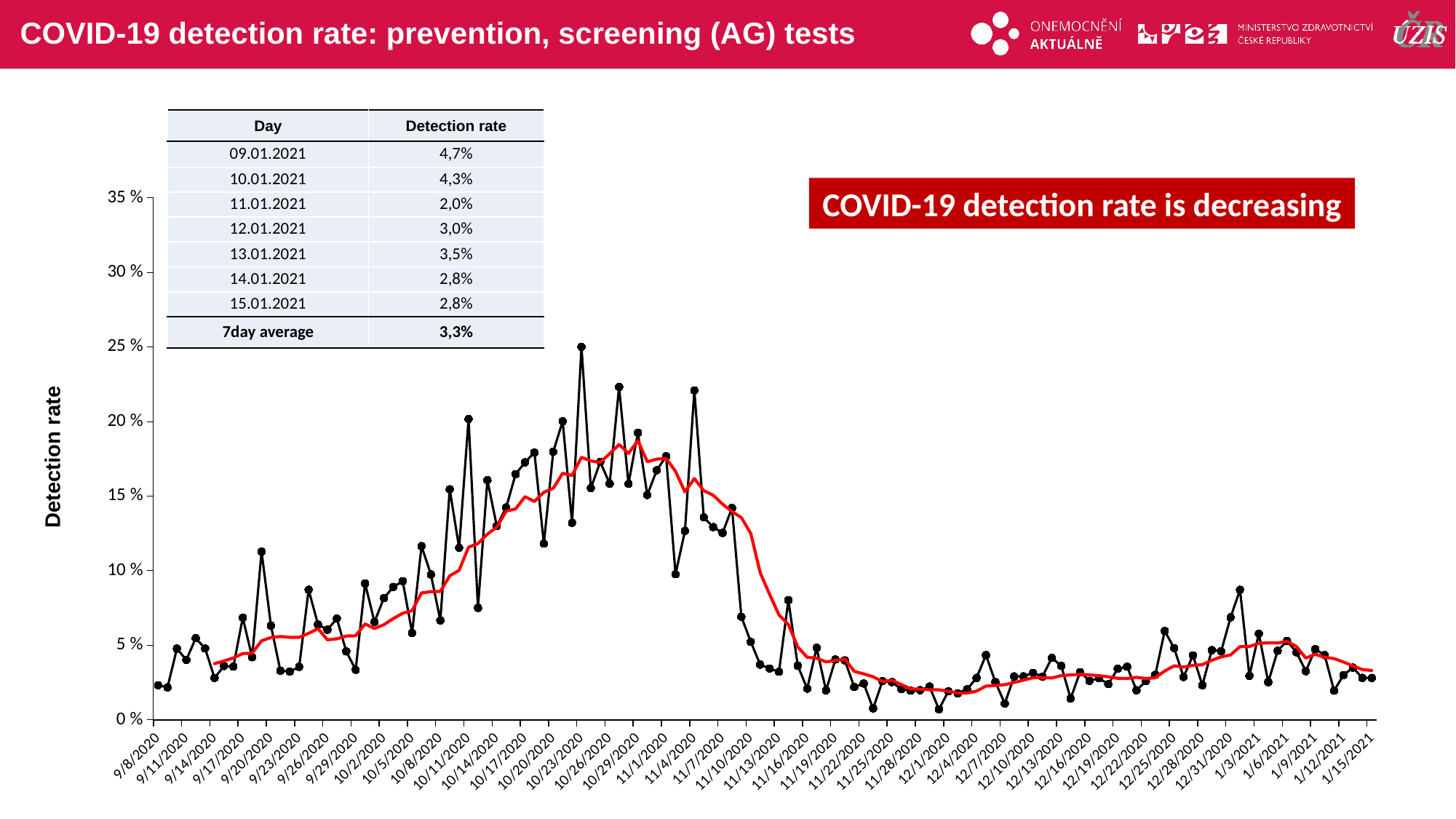
According to the table on the slide, what was the detection rate on 09.01.2021? 4,7% Among the days listed in the table, which day has the lowest detection rate? 11.01.2021 Among the days listed in the table, which day has the highest detection rate? 09.01.2021 What is the 7-day average detection rate given in the table? 3,3% What was the detection rate on 13.01.2021 according to the table? 3,5% Does the detection rate rise or fall between 11/1/2020 and 12/1/2020 on the chart? fall What is the label of the vertical axis of the chart? Detection rate Is the highest daily detection rate plotted on the chart (around 10/23/2020) greater or less than 20 %? greater Is the daily detection rate plotted for 11/25/2020 greater or less than 5 %? less What kind of chart is shown on the slide? line chart What is the difference between the detection rates on 09.01.2021 and 10.01.2021 in the table? 0,4% Which day has the higher detection rate in the table, 11.01.2021 or 12.01.2021? 12.01.2021